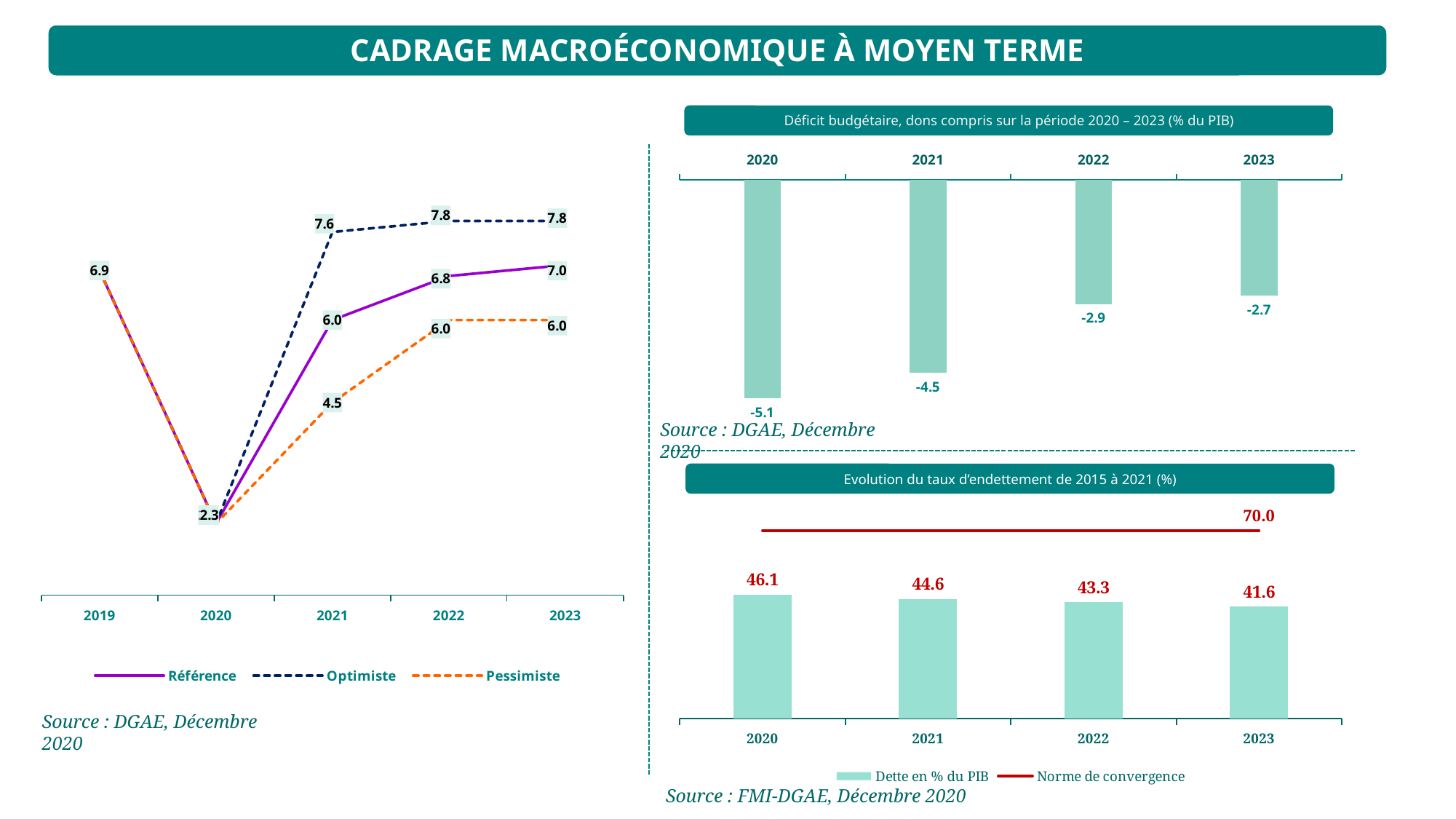
In the chart titled 'Evolution du taux d'endettement de 2015 à 2021 (%)', what is the value of 'Dette en % du PIB' for 2022? 43.3 In the chart titled 'Evolution du taux d'endettement de 2015 à 2021 (%)', do the 'Dette en % du PIB' values rise or fall from 2020 to 2023? fall In the line chart on the left, what is the value of the Optimiste series in 2021? 7.6 In the chart titled 'Déficit budgétaire, dons compris sur la période 2020 – 2023 (% du PIB)', which year has the largest deficit? 2020 In the chart titled 'Evolution du taux d'endettement de 2015 à 2021 (%)', what is the value of the 'Norme de convergence' line? 70.0 In the chart titled 'Déficit budgétaire, dons compris sur la période 2020 – 2023 (% du PIB)', what is the value for 2021? -4.5 In the line chart on the left, how many series does the legend list? 3 In the chart titled 'Déficit budgétaire, dons compris sur la période 2020 – 2023 (% du PIB)', how many years are shown? 4 In the line chart on the left, what is the value of the Pessimiste series in 2021? 4.5 In the line chart on the left, what is the value of the Référence series in 2023? 7.0 In the line chart on the left, which year has the lowest value for all three series? 2020 In the line chart on the left, what is the difference between the Optimiste and Pessimiste values in 2023? 1.8